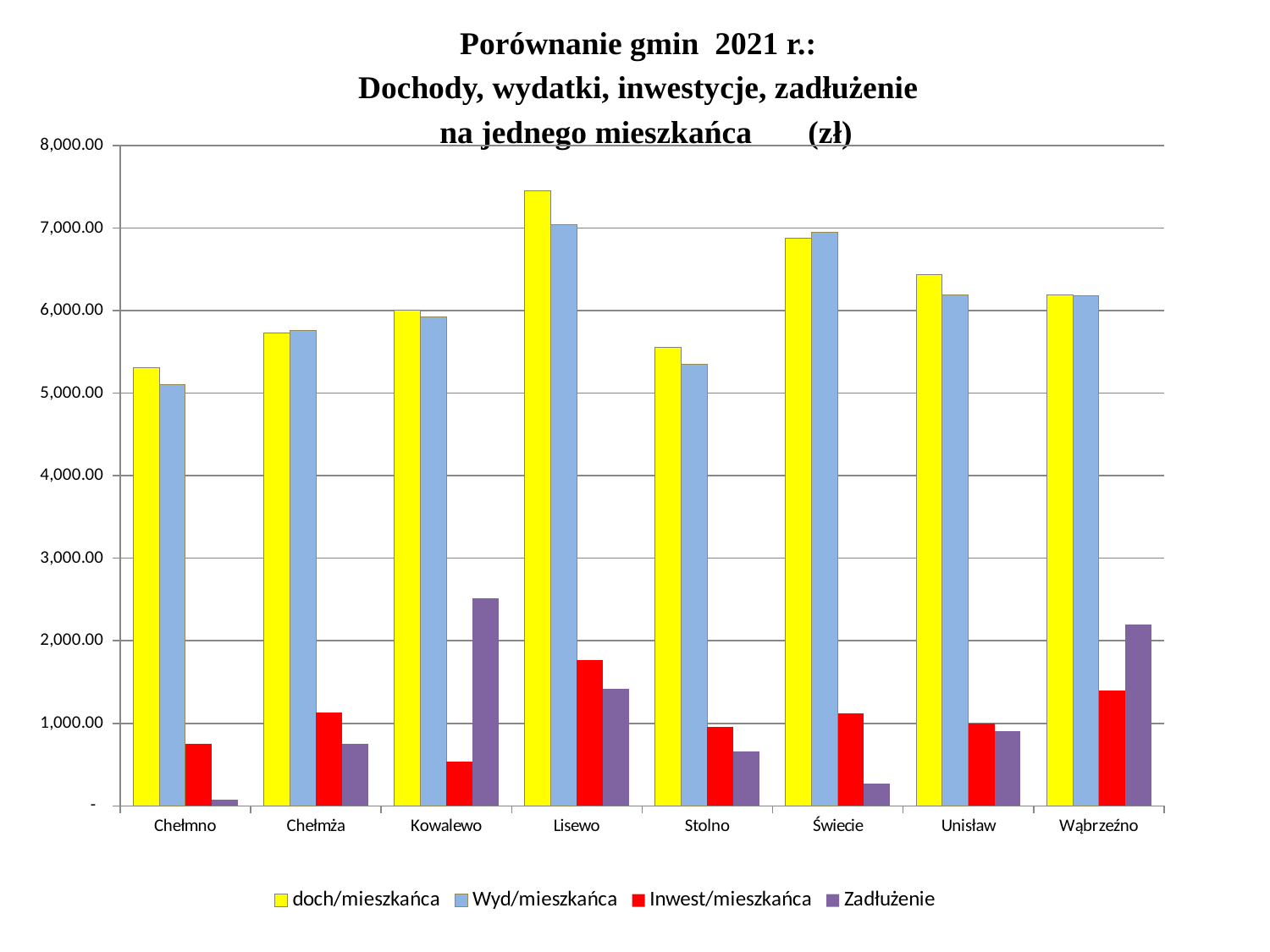
Is the doch/mieszkańca value for Lisewo greater or less than 7,000.00? greater Is the Inwest/mieszkańca value for Kowalewo greater or less than 1,000.00? less How many gminas (categories) are shown on the x axis? 8 What kind of chart is shown on the slide? bar chart How many series does the legend list? 4 Is the Zadłużenie value for Kowalewo greater or less than 2,000.00? greater Which gmina has the lowest doch/mieszkańca value? Chełmno Which gmina has the highest Inwest/mieszkańca value? Lisewo Which is larger, the Inwest/mieszkańca value for Lisewo or for Wąbrzeźno? Lisewo Which gmina has the highest Zadłużenie value? Kowalewo Which gmina has the highest doch/mieszkańca value? Lisewo Which gmina has the lowest Zadłużenie value? Chełmno